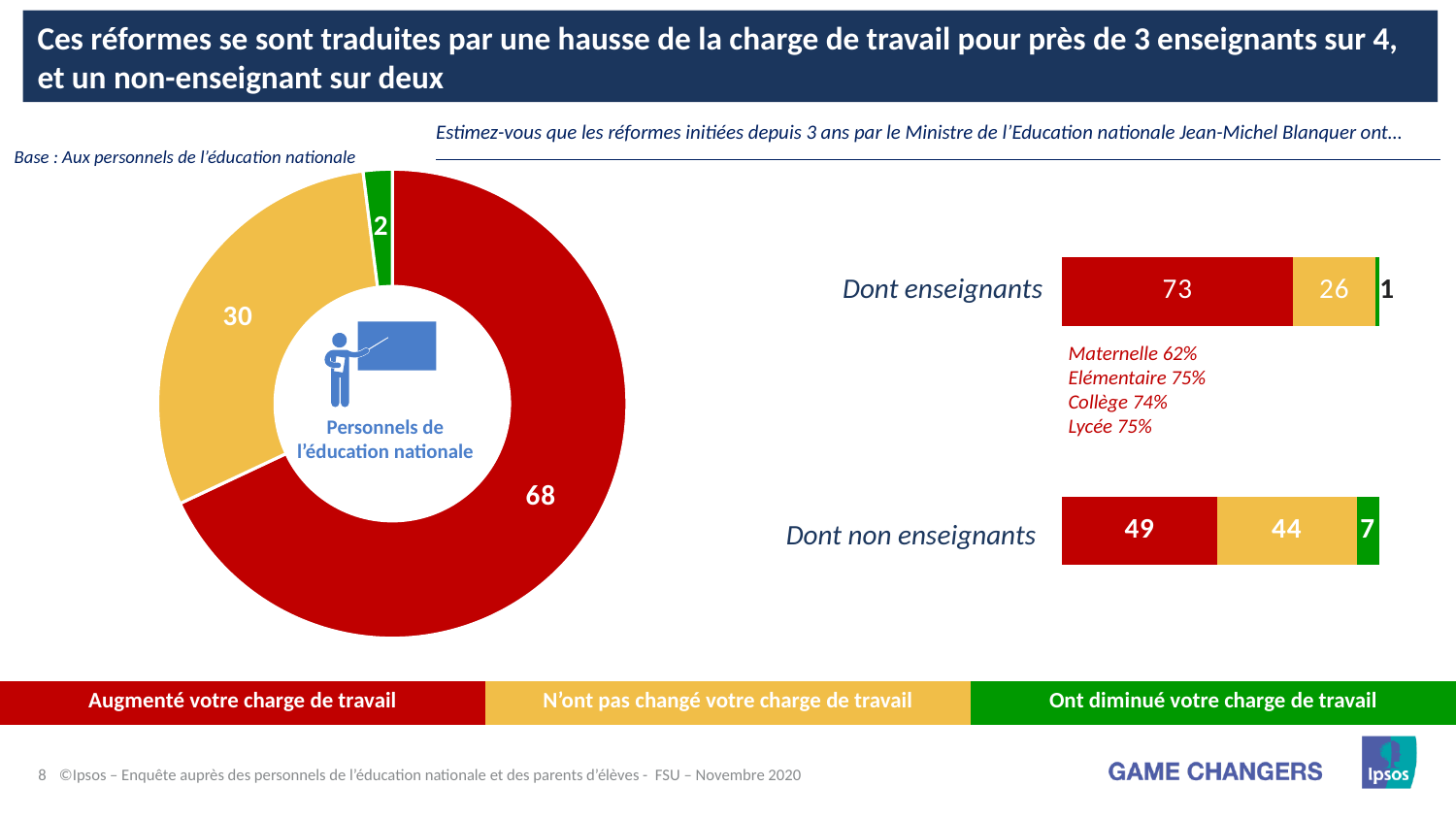
In the 'Dont enseignants' bar, what share say the reforms have not changed their workload? 26 In the donut chart for Personnels de l'éducation nationale, what share say the reforms have not changed their workload? 30 In the 'Dont enseignants' bar, what share say the reforms have increased their workload? 73 In the donut chart for Personnels de l'éducation nationale, which response has the largest share? Augmenté votre charge de travail In the 'Dont non enseignants' bar, what share say the reforms have increased their workload? 49 Which group has a larger share saying the reforms did not change their workload: enseignants or non enseignants? non enseignants In the 'Dont non enseignants' bar, what share say the reforms have decreased their workload? 7 In the donut chart for Personnels de l'éducation nationale, what share say the reforms have decreased their workload? 2 In the donut chart for Personnels de l'éducation nationale, which response has the smallest share? Ont diminué votre charge de travail What kind of chart shows the results for Personnels de l'éducation nationale on the left of the slide? Donut (pie) chart What is the difference between the share of enseignants and the share of non enseignants who say the reforms increased their workload? 24 In the donut chart for Personnels de l'éducation nationale, what share say the reforms have increased their workload (Augmenté votre charge de travail)? 68